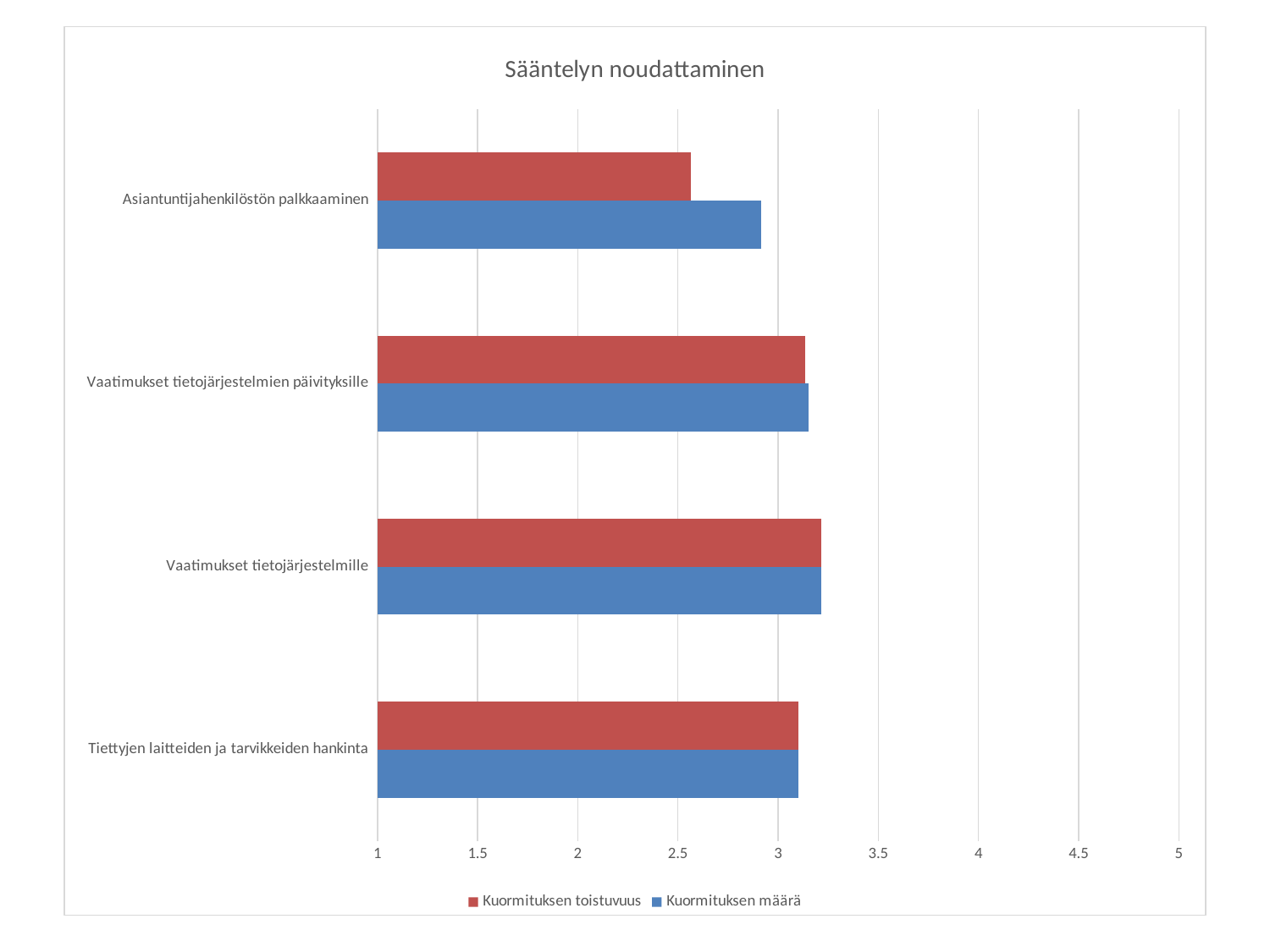
For Asiantuntijahenkilöstön palkkaaminen, which series has the larger value, Kuormituksen toistuvuus or Kuormituksen määrä? Kuormituksen määrä Which category has the lowest Kuormituksen toistuvuus value? Asiantuntijahenkilöstön palkkaaminen How many categories are shown on the chart? 4 Is the Kuormituksen toistuvuus value for Vaatimukset tietojärjestelmille greater or less than 3? greater Is the Kuormituksen toistuvuus value for Asiantuntijahenkilöstön palkkaaminen greater or less than 3? less Which series is shown in red? Kuormituksen toistuvuus Is the Kuormituksen määrä value for Asiantuntijahenkilöstön palkkaaminen greater or less than 3? less What is the title of the chart? Sääntelyn noudattaminen Which category has the highest Kuormituksen toistuvuus value? Vaatimukset tietojärjestelmille How many series does the legend list? 2 What type of chart is shown on the slide? bar chart